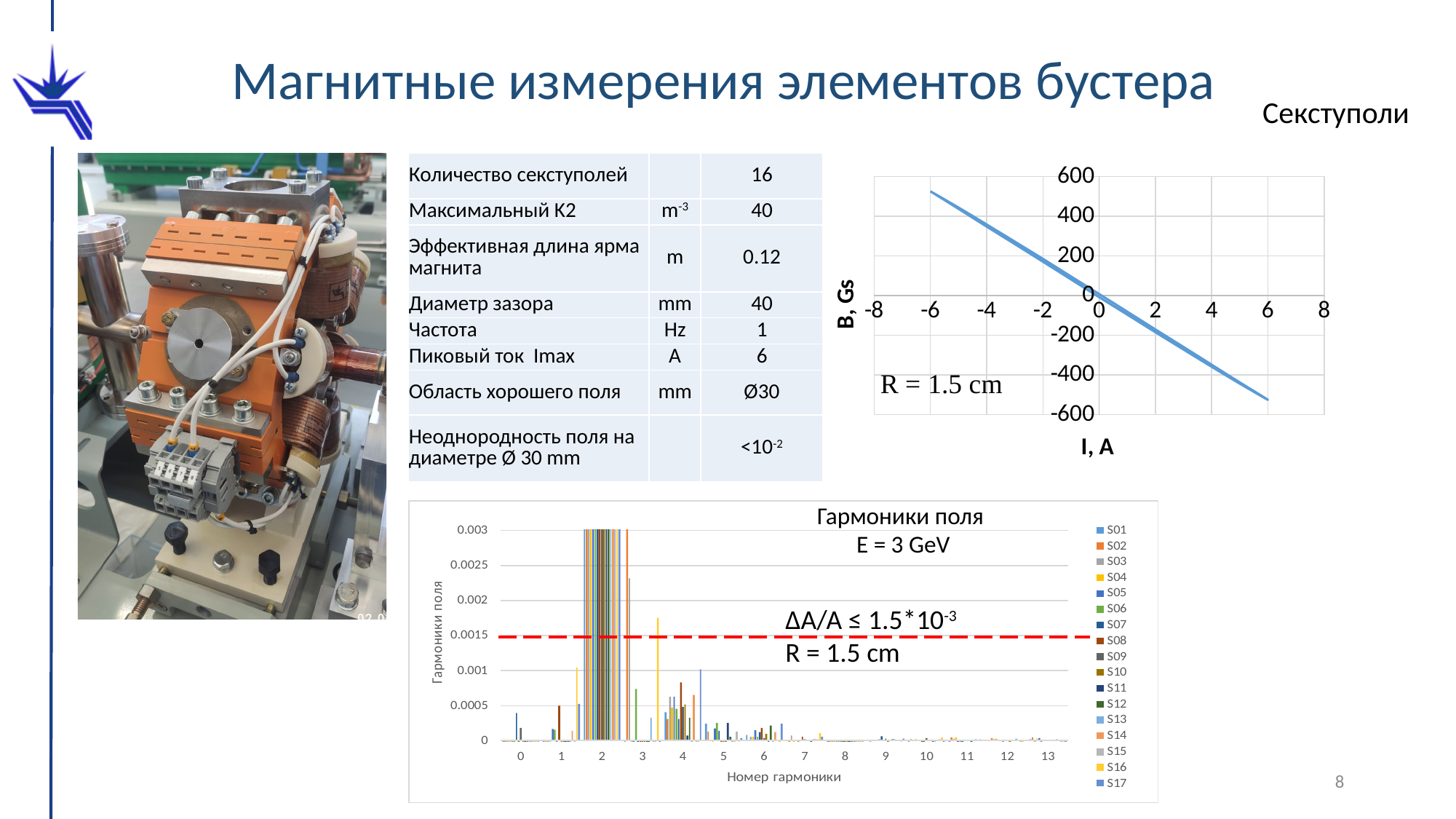
What kind of chart is the bottom chart titled 'Гармоники поля'? bar chart In the top-right chart of B, Gs versus I, A, is the value of B at I = 6 greater or less than -400? less In the top-right chart of B, Gs versus I, A, is the value of B at I = -6 greater or less than 400? greater In the bottom chart 'Гармоники поля', is the tallest bar at harmonic number 4 greater or less than 0.0015? less In the top-right chart of B, Gs versus I, A, which is larger: the value of B at I = -4 or at I = 4? I = -4 In the bottom chart 'Гармоники поля', at what value is the red dashed horizontal line drawn? 0.0015 What is the label of the horizontal axis of the top-right chart? I, A What kind of chart is the top-right chart with axes B, Gs and I, A? line chart How many harmonic numbers are shown on the x axis of the bottom chart 'Гармоники поля'? 14 In the top-right chart of B, Gs versus I, A, does the value of B rise or fall as I increases? fall In the bottom chart 'Гармоники поля', which harmonic number has the highest bars? 2 How many series does the legend of the bottom chart 'Гармоники поля' list? 17